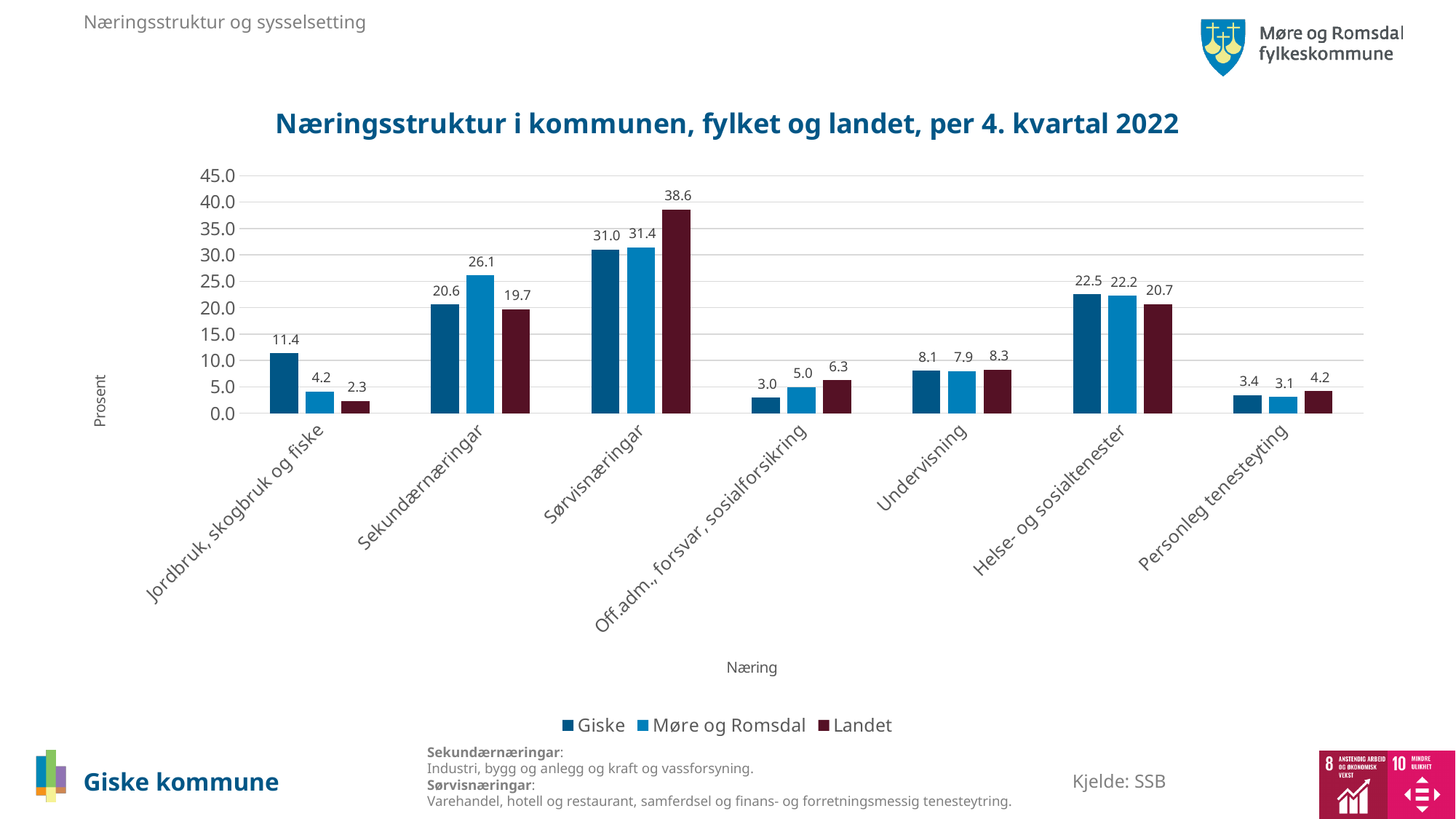
Which is larger in the Sekundærnæringar category: Giske or Møre og Romsdal? Møre og Romsdal What kind of chart is shown on the slide? Bar chart What is the difference between the Landet and Giske values for Sørvisnæringar? 7.6 How many categories are shown on the x axis? 7 Which category has the highest value for Giske? Sørvisnæringar Which category has the lowest value for Landet? Jordbruk, skogbruk og fiske What is the title of the chart? Næringsstruktur i kommunen, fylket og landet, per 4. kvartal 2022 How many series does the legend list? 3 What is the value for Landet in the Sørvisnæringar category? 38.6 Is the value for Giske in Helse- og sosialtenester greater or less than 20.0? greater What is the value for Møre og Romsdal in the Sekundærnæringar category? 26.1 What is the value for Giske in the Jordbruk, skogbruk og fiske category? 11.4